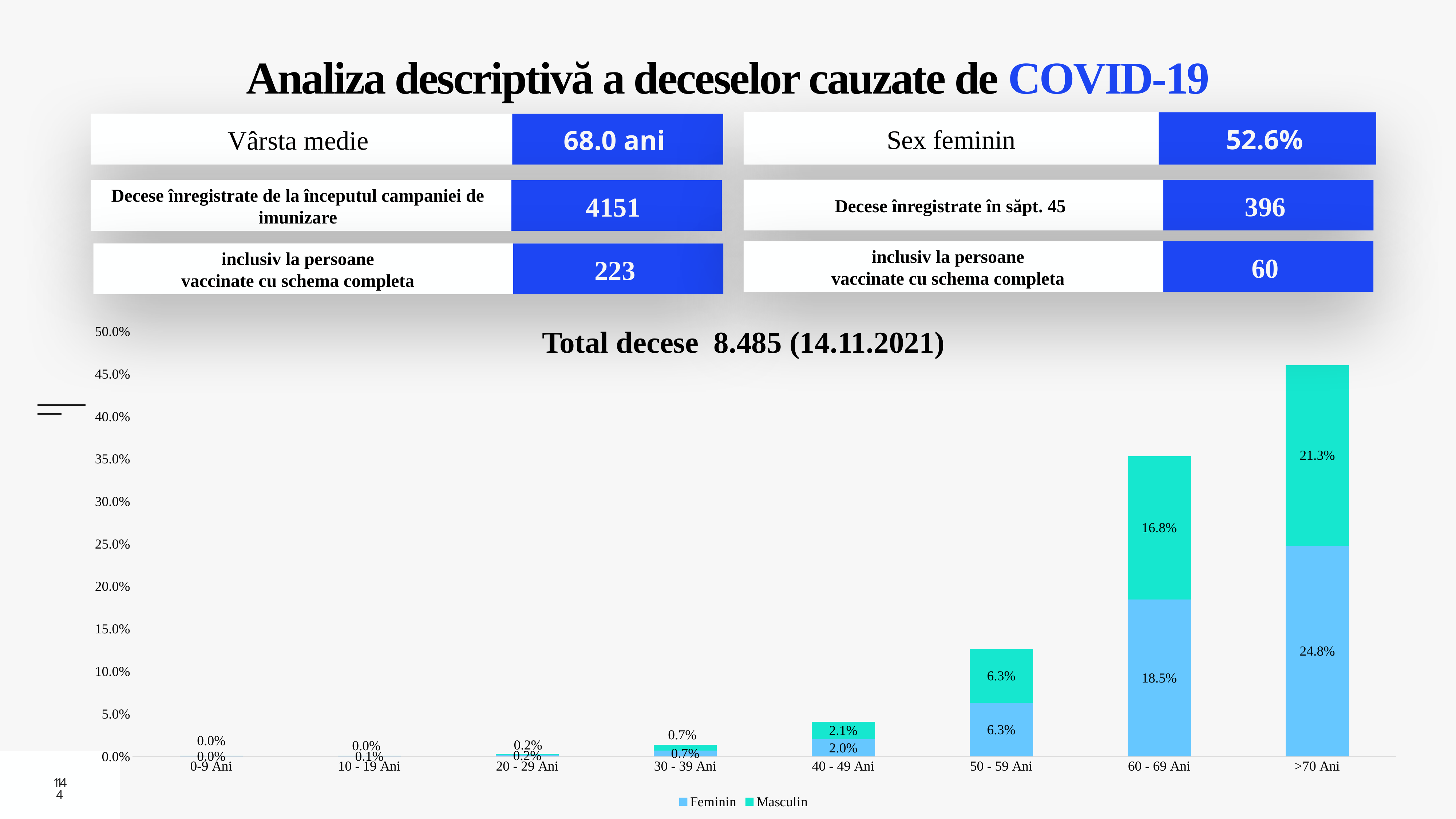
What is the Masculin value for the 40 - 49 Ani age group? 2.1% How many age groups are shown on the x axis? 8 How many series does the legend list? 2 What is the Masculin value for the 60 - 69 Ani age group? 16.8% Do the Masculin values rise or fall as the age groups increase along the x axis? Rise Which is larger for the 60 - 69 Ani age group, the Feminin value or the Masculin value? Feminin What is the Feminin value for the >70 Ani age group? 24.8% What kind of chart is shown on the slide? Stacked bar chart What is the Feminin value for the 50 - 59 Ani age group? 6.3% What is the total of the stacked bar for the 60 - 69 Ani age group? 35.3% Which age group has the highest Feminin value? >70 Ani What is the difference between the Feminin and Masculin values for the >70 Ani age group? 3.5%